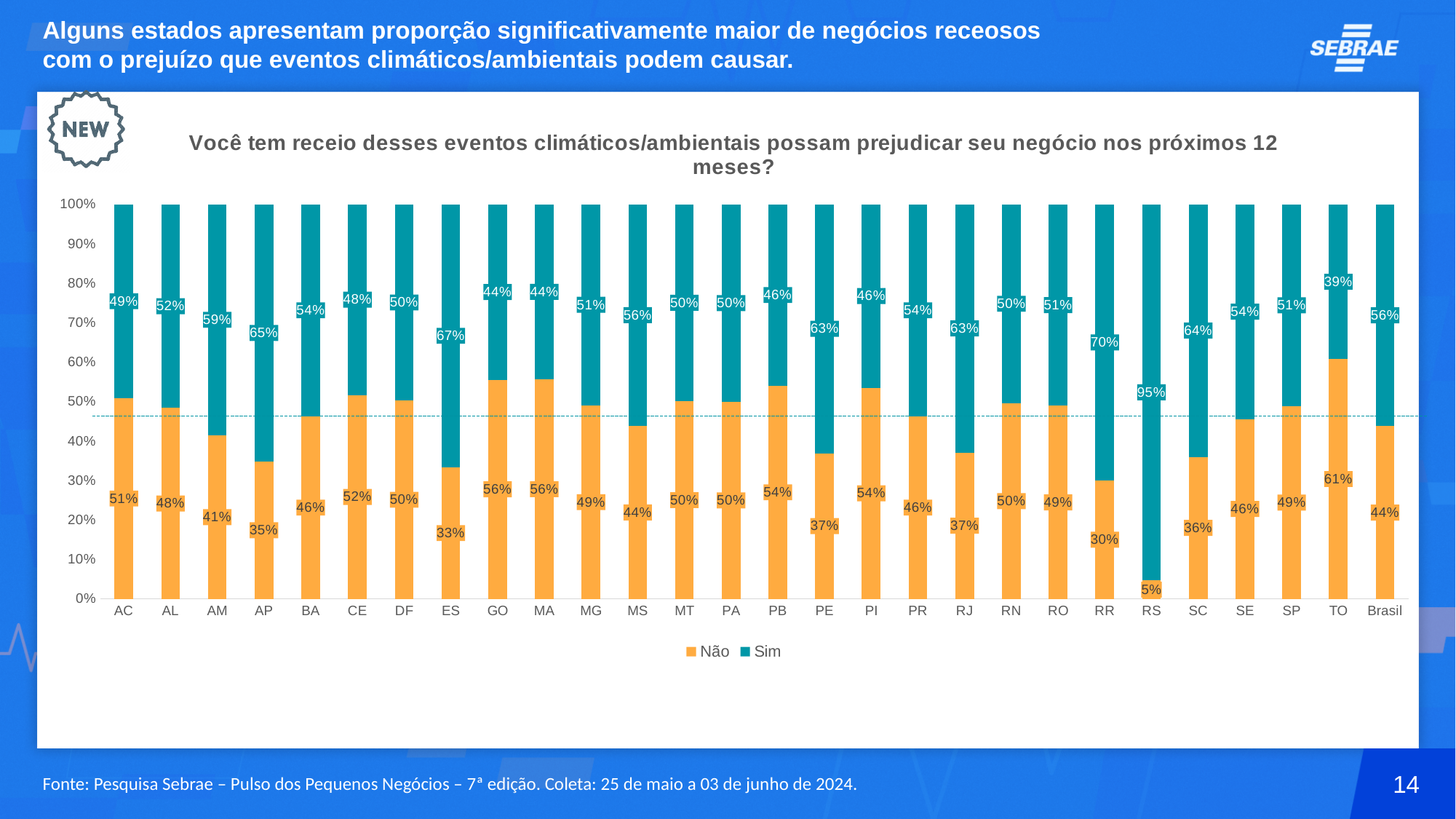
How many series does the legend list? 2 Which category has the lowest 'Não' value? RS What is the 'Sim' value for ES? 67% What kind of chart is shown on the slide? Stacked bar chart What is the total of the stacked bar for TO? 100% Which is larger, the 'Sim' value for PE or the 'Sim' value for MG? PE What is the 'Sim' value for RS? 95% How many categories are shown on the x axis? 28 Which category has the lowest 'Sim' value? TO Which category has the highest 'Sim' value? RS What is the 'Não' value for Brasil? 44% What is the difference between the 'Sim' values for RR and AC? 21%